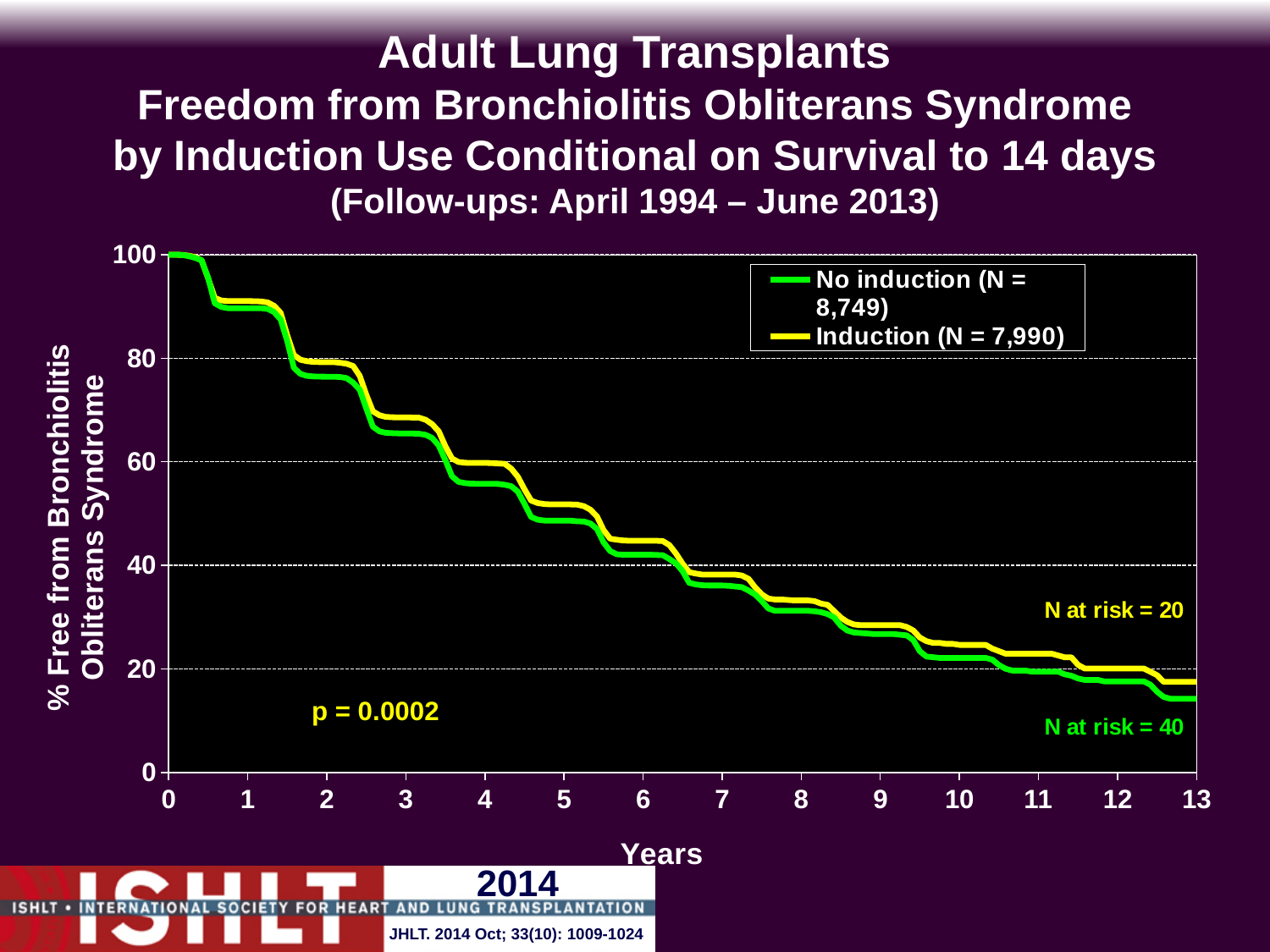
What is the N at risk printed next to the Induction (yellow) curve at the end of follow-up? 20 What kind of chart is shown on the slide? line chart How many series does the legend list? 2 Do the curves rise or fall as years since transplant increase? fall What is the N at risk printed next to the No induction (green) curve at the end of follow-up? 40 Is the value for the Induction series at 3 years greater or less than 60? greater What is the N for the No induction series as given in the legend? 8,749 What p-value is printed on the chart? p = 0.0002 Is the value for the No induction series at 13 years greater or less than 20? less Is the value for the No induction series at 7 years greater or less than 40? less At 13 years, which series has the higher % free from bronchiolitis obliterans syndrome, Induction or No induction? Induction What is the N for the Induction series as given in the legend? 7,990